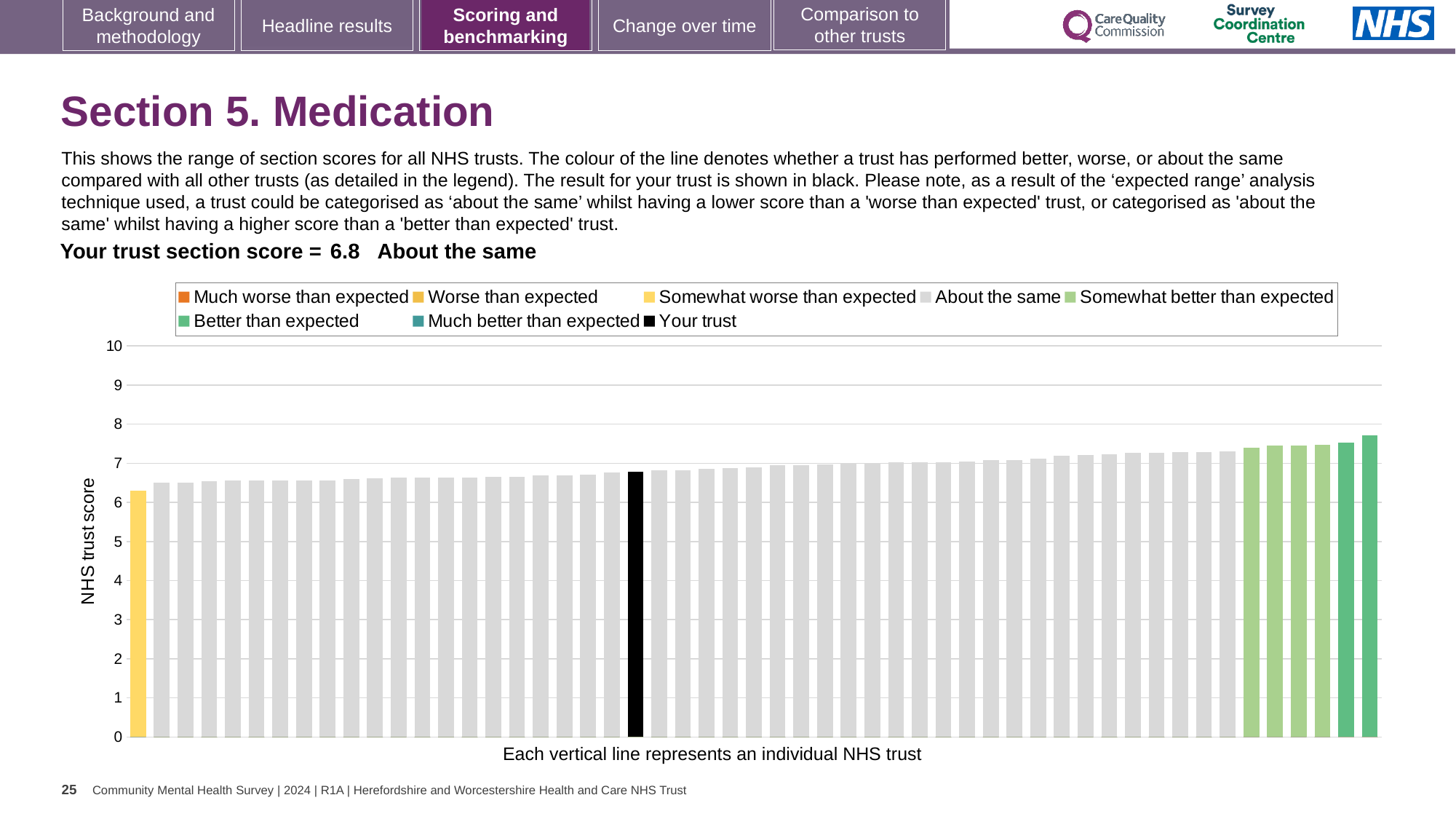
What colour is the bar representing your trust? black Which is higher: the black 'Your trust' bar or the yellow 'Worse than expected' bar? the black 'Your trust' bar What is the section score for your trust shown on the slide? 6.8 Is the value of the highest bar greater or less than 8? less How many entries does the chart legend list? 8 How many bars are coloured yellow (Worse than expected)? 1 How many bars are coloured dark green (Better than expected)? 2 What kind of chart is shown on the slide? bar chart Is the value of the black 'Your trust' bar greater or less than 5? greater Do the bar values rise or fall from left to right along the x axis? rise What is the label on the vertical axis of the chart? NHS trust score Is the value of the lowest (yellow) bar greater or less than 7? less